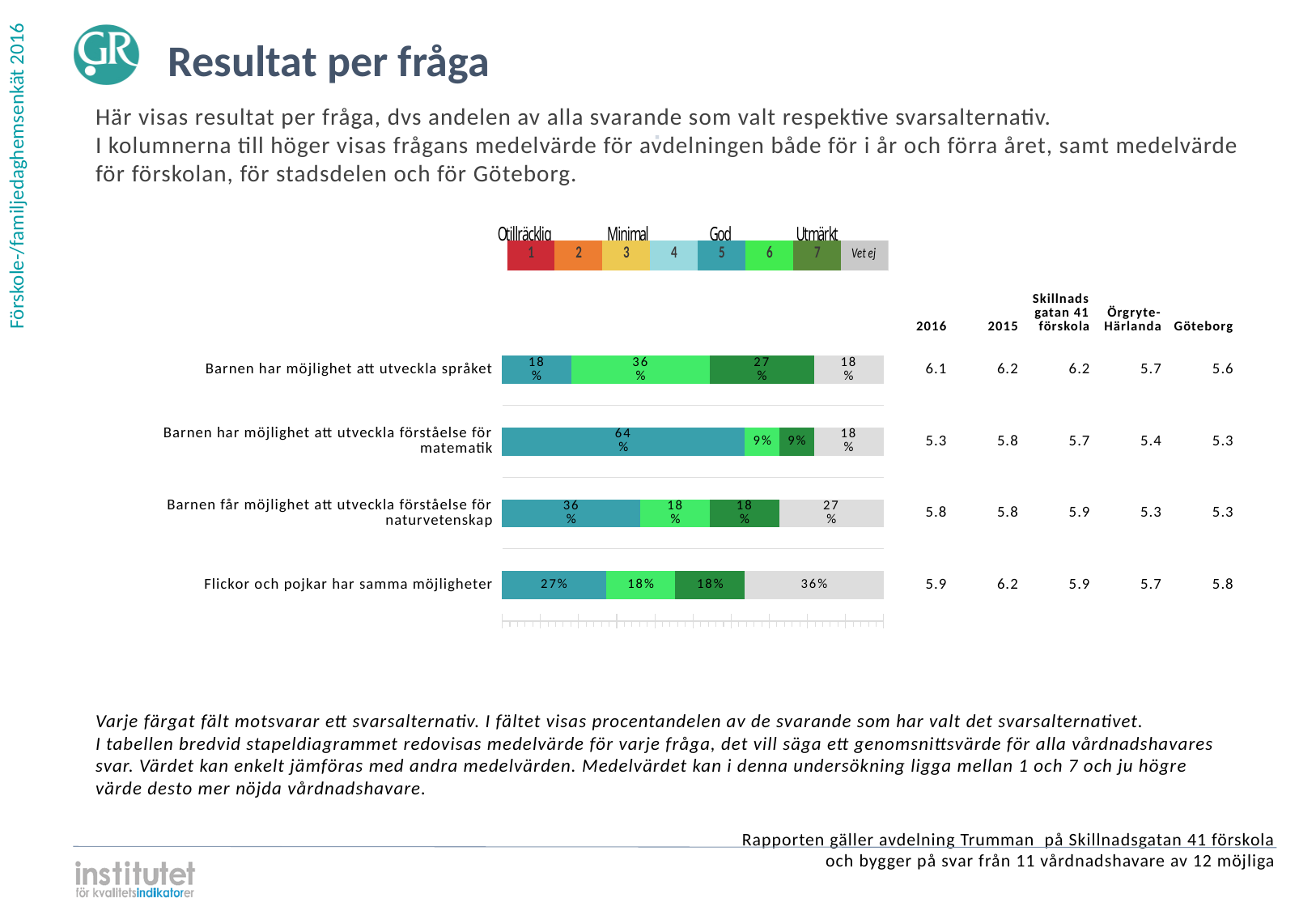
Which question has the largest share for option 5 (teal)? Barnen har möjlighet att utveckla förståelse för matematik What kind of chart is shown on the slide? Stacked bar chart What percentage of respondents chose option 6 (light green) for 'Barnen har möjlighet att utveckla språket'? 36% Is the option 6 share larger for 'Barnen har möjlighet att utveckla språket' or for 'Barnen får möjlighet att utveckla förståelse för naturvetenskap'? Barnen har möjlighet att utveckla språket How many response options does the legend above the chart list, including 'Vet ej'? 8 Which question has the largest 'Vet ej' (grey) share? Flickor och pojkar har samma möjligheter How many questions (categories) are plotted in the bar chart? 4 What is the 2016 mean value shown for 'Barnen har möjlighet att utveckla språket'? 6.1 What percentage of respondents chose option 5 (teal) for 'Barnen har möjlighet att utveckla förståelse för matematik'? 64% What is the difference between the option 7 (dark green) share for 'Barnen har möjlighet att utveckla språket' and for 'Barnen har möjlighet att utveckla förståelse för matematik'? 18 percentage points What is the combined share of options 5, 6 and 7 for 'Barnen får möjlighet att utveckla förståelse för naturvetenskap'? 72% What is the 'Vet ej' share for 'Flickor och pojkar har samma möjligheter'? 36%